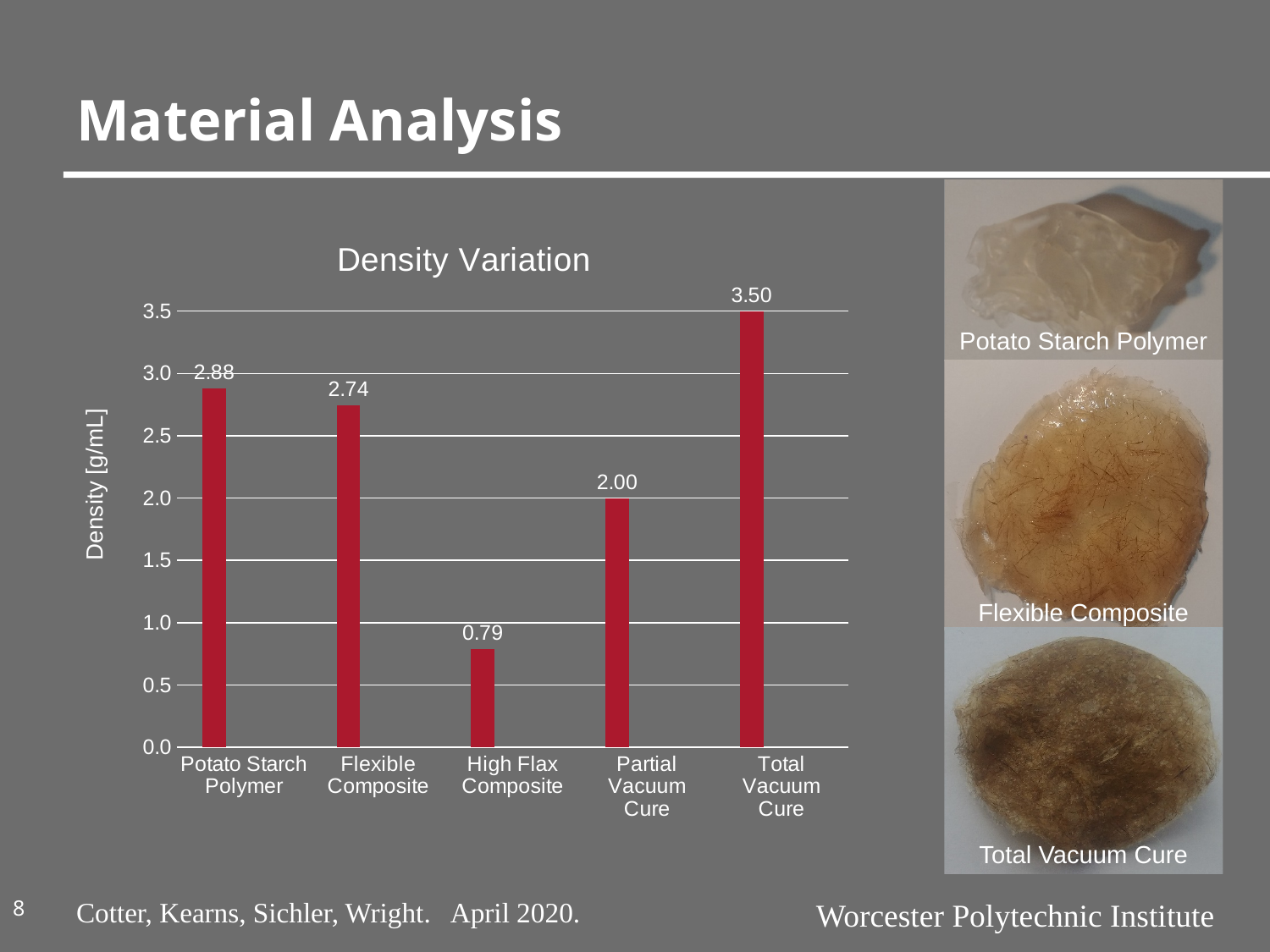
What is the density value for High Flax Composite? 0.79 Is the density value for Flexible Composite greater or less than 3.0? less What is the density value for Potato Starch Polymer in the Density Variation chart? 2.88 Which category has the highest density in the chart? Total Vacuum Cure Which category has the lowest density in the chart? High Flax Composite What kind of chart is the Density Variation chart? bar chart What is the density value for Partial Vacuum Cure? 2.00 How many categories are shown in the Density Variation chart? 5 Which has a higher density, Flexible Composite or Partial Vacuum Cure? Flexible Composite What is the difference in density between Total Vacuum Cure and Partial Vacuum Cure? 1.50 What is the label of the y axis in the Density Variation chart? Density [g/mL] What is the difference in density between Potato Starch Polymer and Flexible Composite? 0.14